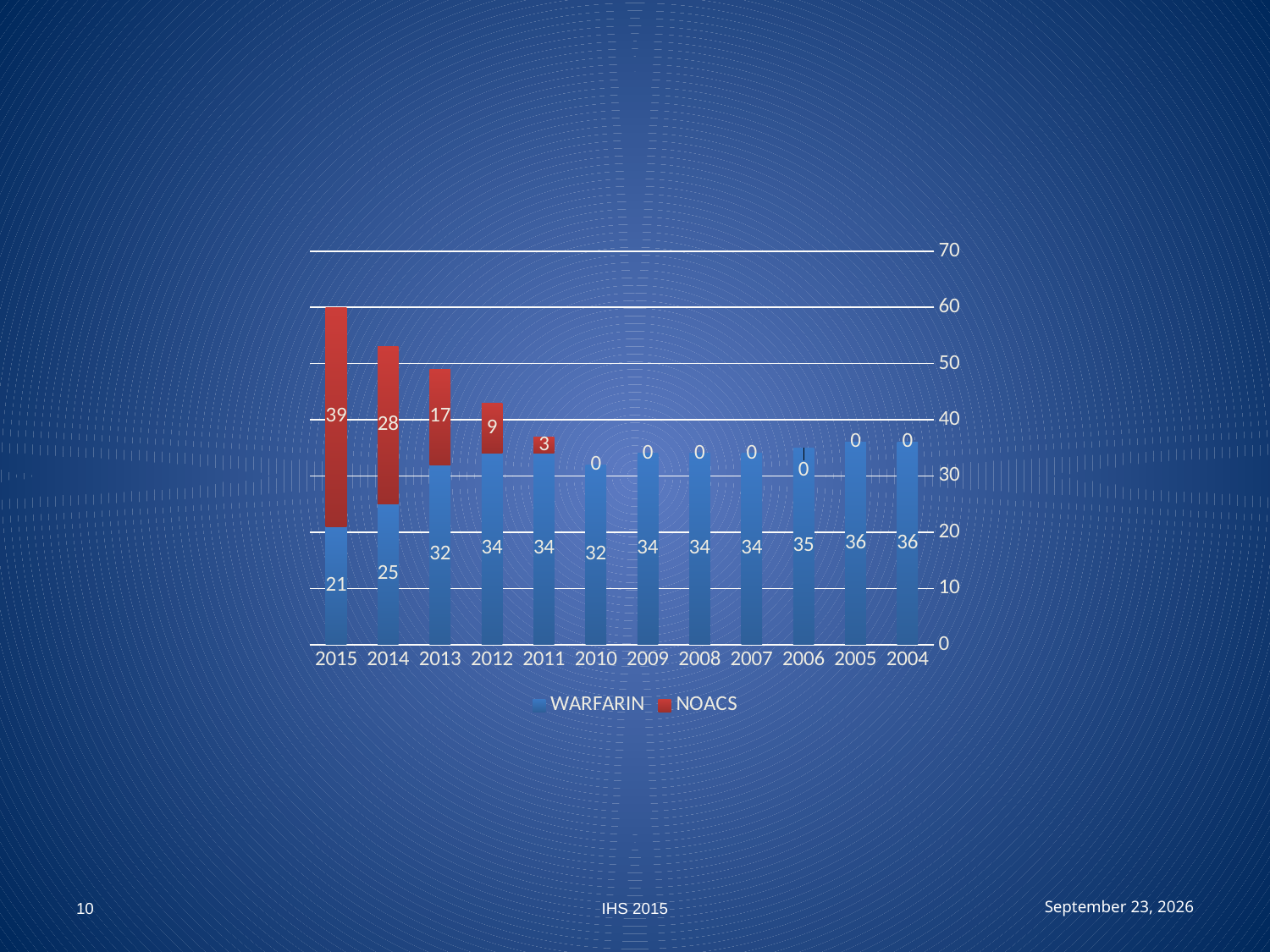
What kind of chart is shown on the slide? Stacked bar chart What is the total of the stacked bar for 2015? 60 How many years are shown on the x axis? 12 What is the NOACS value for 2014? 28 What is the difference between the NOACS values for 2015 and 2013? 22 What is the WARFARIN value for 2015? 21 Which is larger, the WARFARIN value for 2014 or the WARFARIN value for 2004? 2004 How many series does the legend list? 2 Which year has the lowest WARFARIN value? 2015 What is the NOACS value for 2011? 3 Which year has the highest NOACS value? 2015 What is the total of the stacked bar for 2013? 49